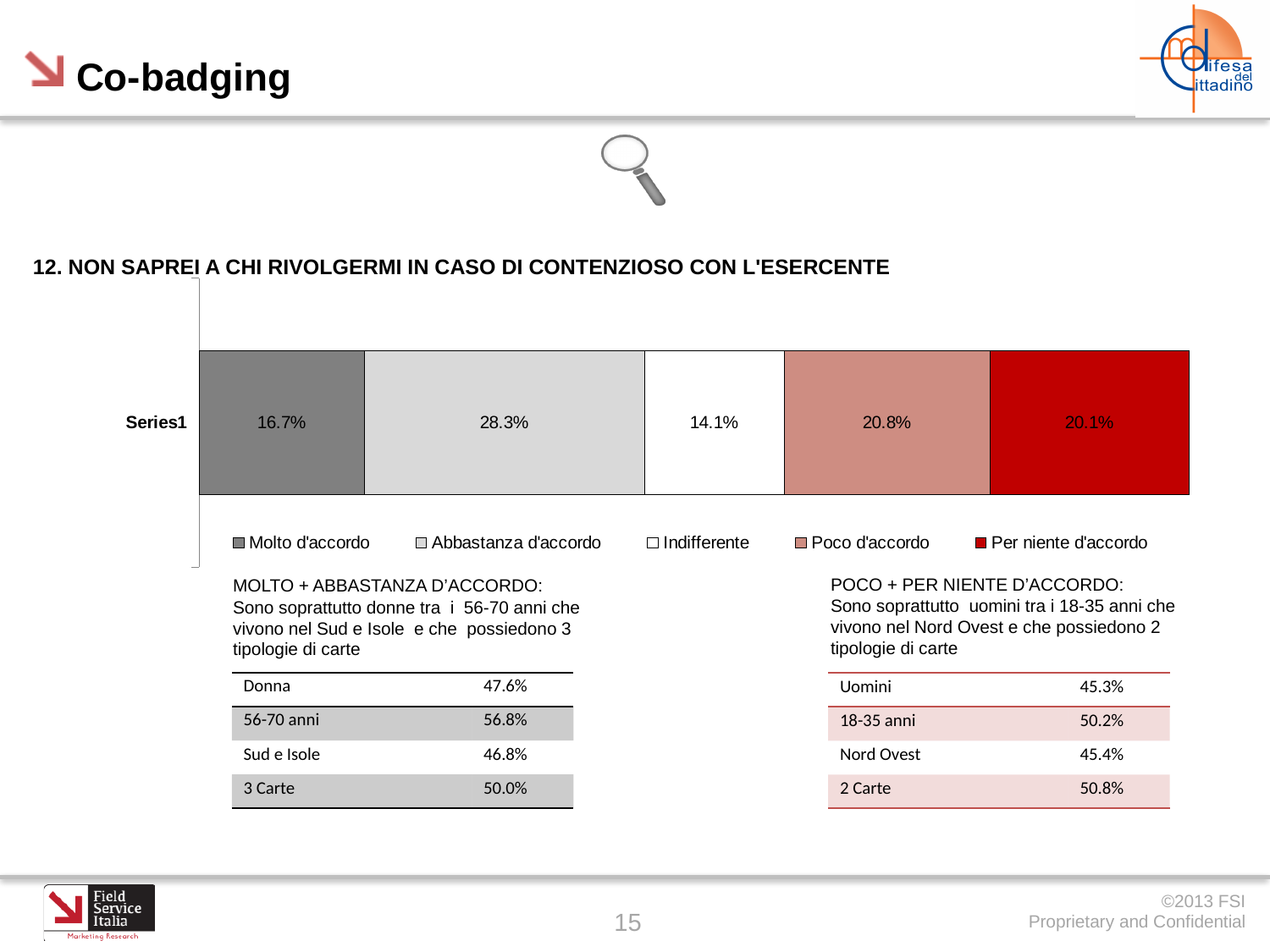
What is the value for Poco d'accordo in the stacked bar? 20.8% What is the value for Indifferente in the stacked bar? 14.1% What is the value for Per niente d'accordo in the stacked bar? 20.1% Which series has the largest segment in the stacked bar? Abbastanza d'accordo What is the value for Molto d'accordo in the stacked bar? 16.7% What is the total of the stacked bar for Series1? 100.0% What kind of chart is shown on the slide? Stacked bar chart What is the value for Abbastanza d'accordo in the stacked bar? 28.3% Which series has the smallest segment in the stacked bar? Indifferente How many series does the legend list? 5 Which is larger, Poco d'accordo or Per niente d'accordo? Poco d'accordo What is the difference between the Abbastanza d'accordo and Molto d'accordo values? 11.6%